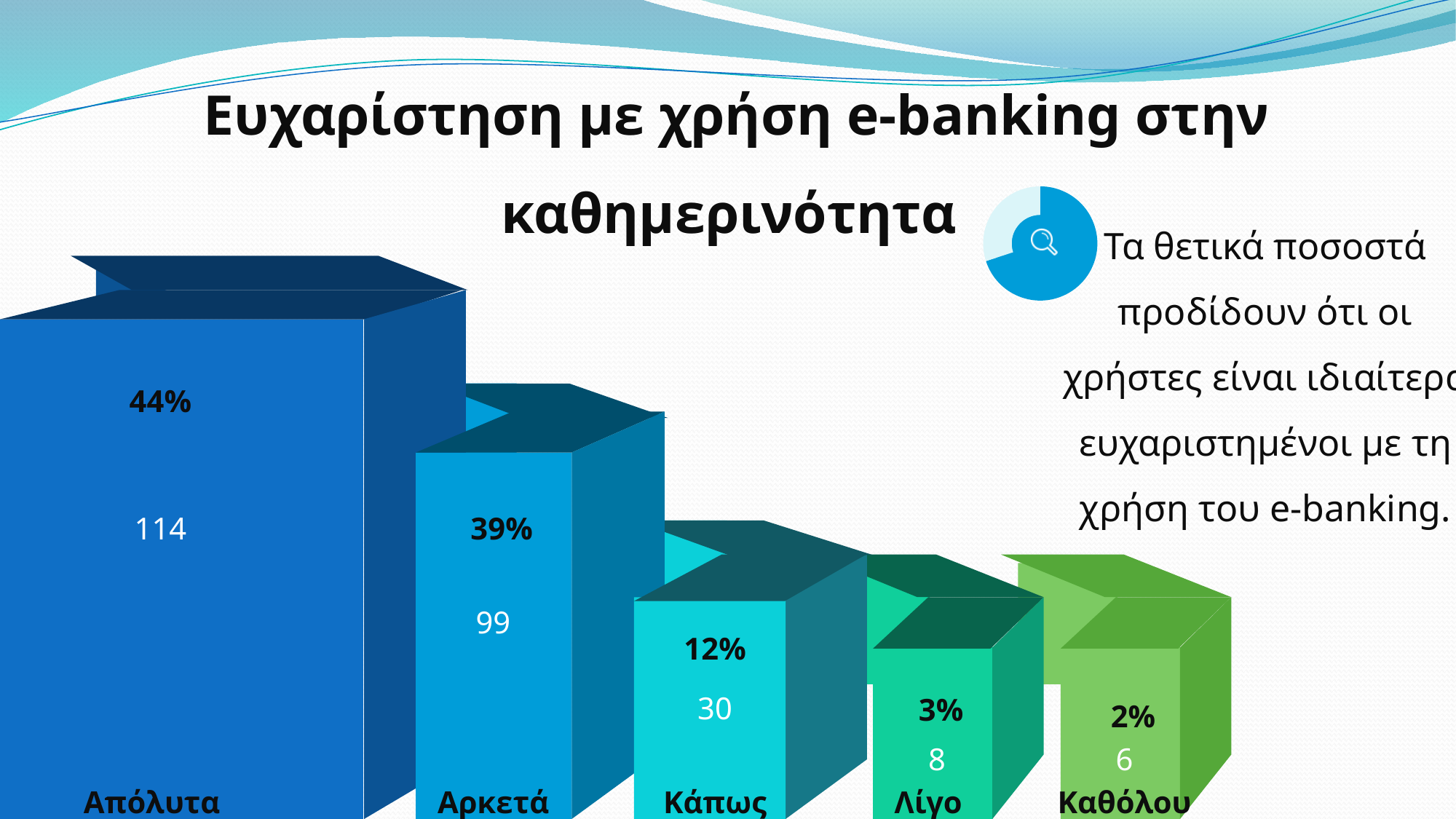
How many categories does the chart show? 5 Do the values rise or fall from left to right across the categories? Fall What count is shown for the Καθόλου bar? 6 What kind of chart is shown on the slide? Bar chart What count is shown for the Απόλυτα bar? 114 What count is shown for the Κάπως bar? 30 What percentage is shown for the Λίγο bar? 3% Which is larger, the count for Κάπως or the count for Λίγο? Κάπως What percentage is shown for the Αρκετά bar? 39% Which category has the lowest value? Καθόλου What is the difference in count between Απόλυτα and Αρκετά? 15 Which category has the highest value? Απόλυτα